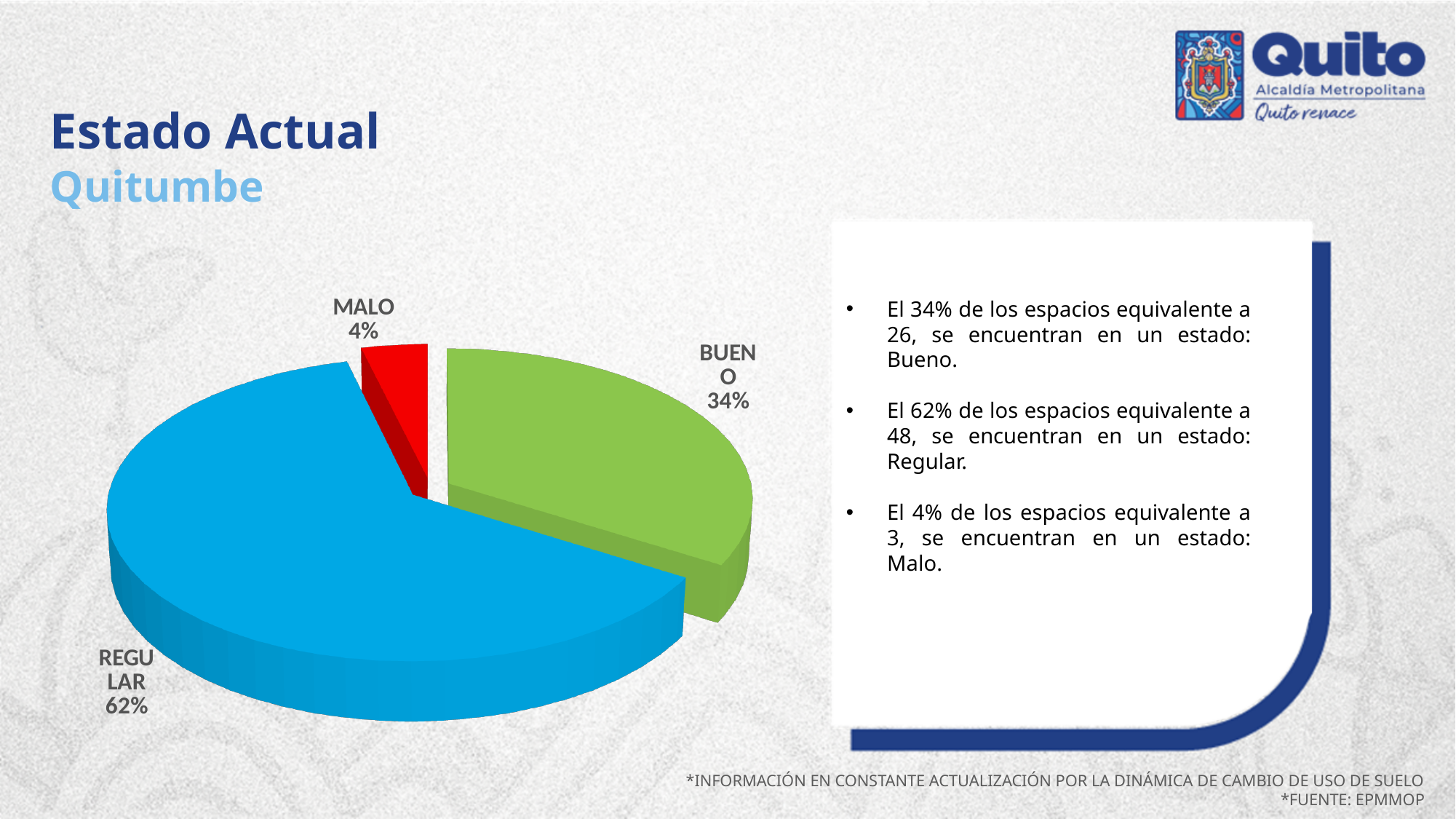
What percentage of the pie chart is labelled REGULAR? 62% What is the difference in percentage points between the BUENO and MALO slices? 30 How many slices does the pie chart have? 3 What colour is the REGULAR slice of the pie chart? Blue What colour is the MALO slice of the pie chart? Red What kind of chart is shown on the slide? Pie chart What is the difference in percentage points between the REGULAR and BUENO slices? 28 Which category has the smallest slice of the pie chart? MALO What percentage of the pie chart is labelled MALO? 4% Which slice is larger, BUENO or MALO? BUENO What percentage of the pie chart is labelled BUENO? 34% Which category has the largest slice of the pie chart? REGULAR